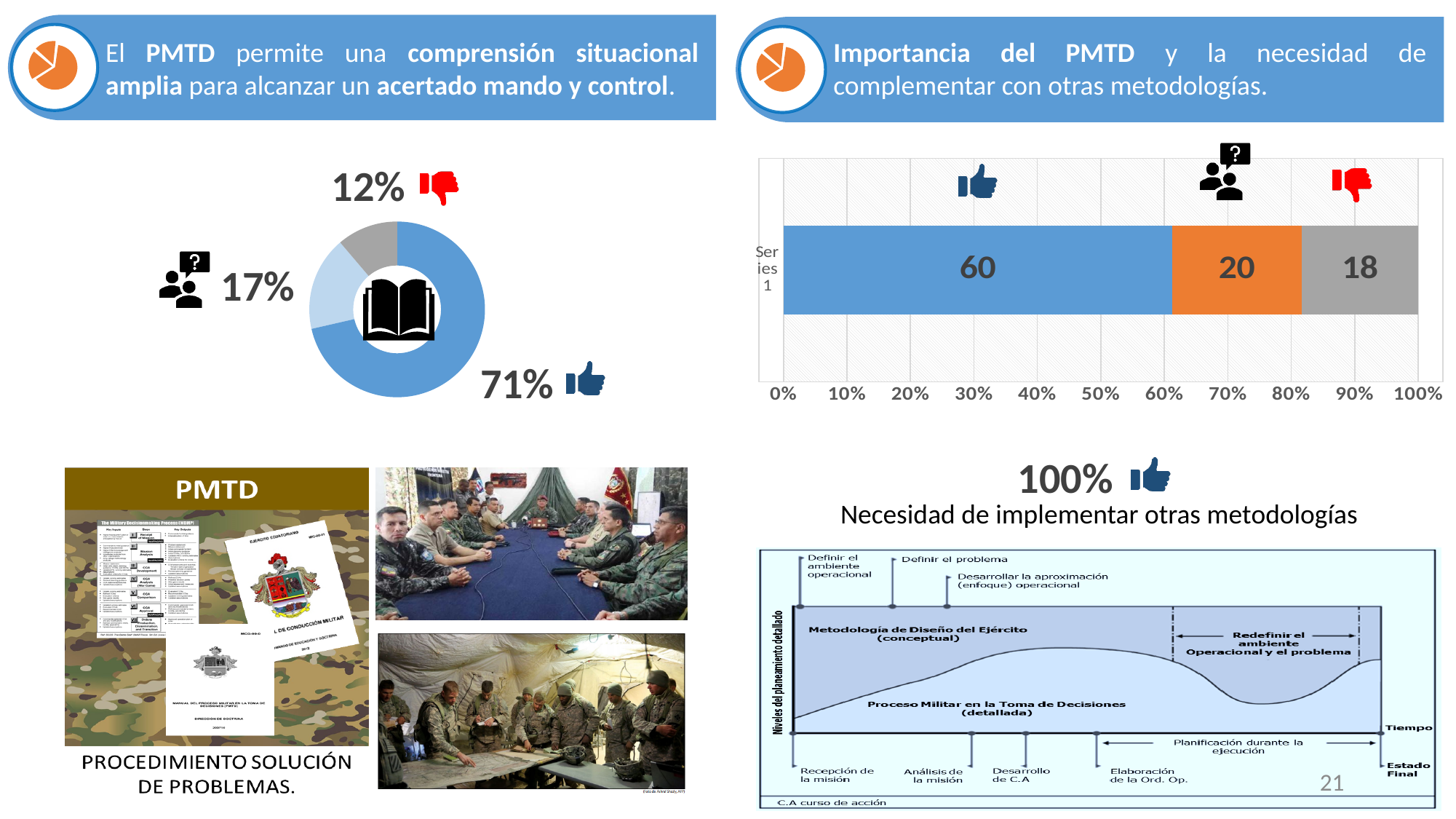
On the left donut chart, what is the difference between the thumbs-up value and the thumbs-down value? 59 percentage points On the right stacked bar chart, which is larger, the orange segment or the grey segment? The orange segment (20) On the left donut chart, which slice is the largest? The thumbs-up slice (71%) How many slices does the left donut chart have? 3 On the left donut chart, what percentage is shown next to the people-with-question-mark icon? 17% What kind of chart is the chart on the left side of the slide? Donut (pie) chart On the left donut chart, which slice is the smallest? The thumbs-down slice (12%) On the right stacked bar chart, what value is printed on the blue segment? 60 On the left donut chart, what percentage is shown next to the thumbs-down icon? 12% On the right stacked bar chart, what value is printed on the grey segment? 18 On the right stacked bar chart, what is the total of the three segments (60, 20 and 18)? 98 On the left donut chart, what percentage is shown next to the thumbs-up icon? 71%